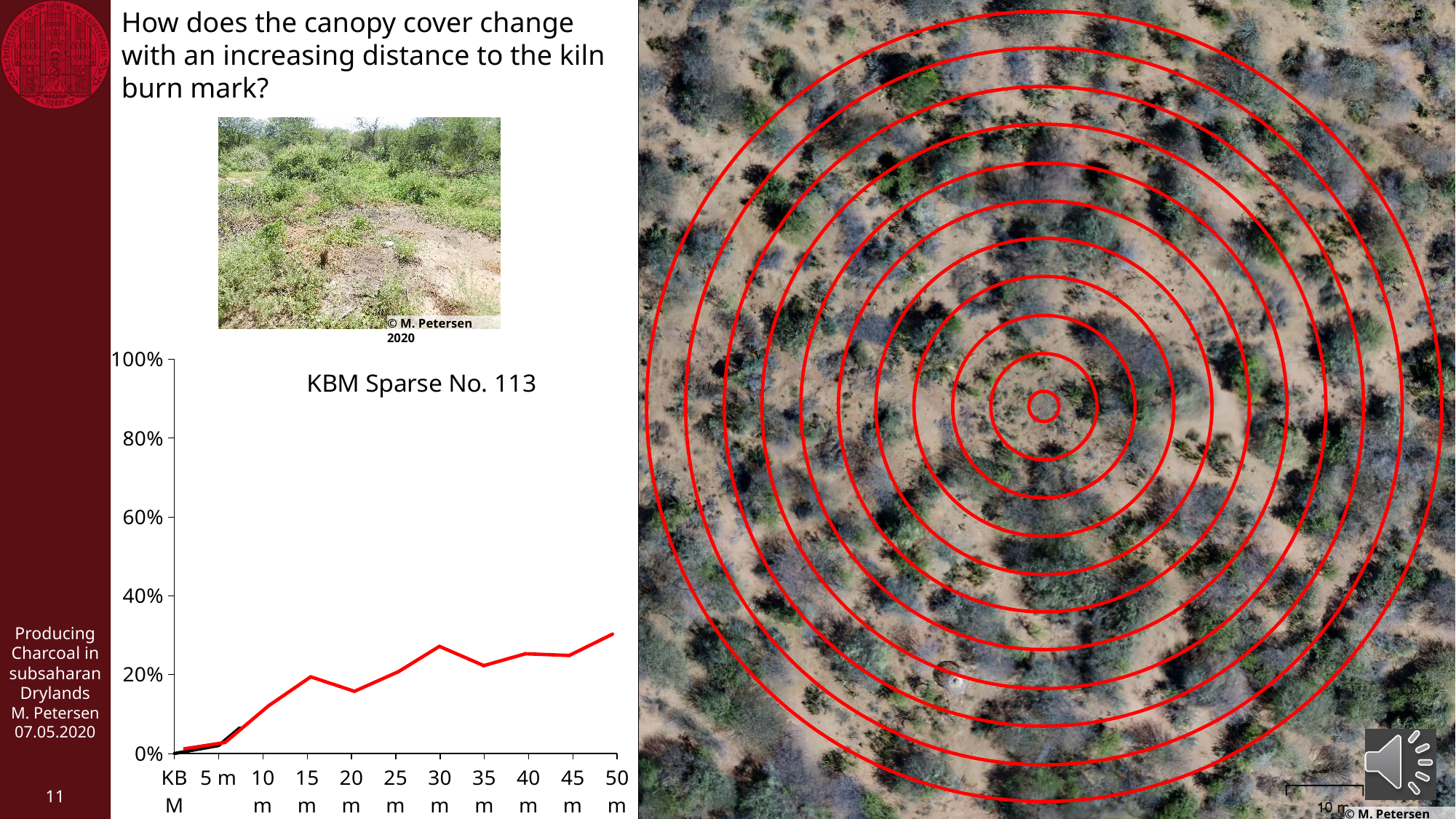
Is the canopy cover at 30 m greater or less than 40%? less Is the canopy cover at 5 m greater or less than 20%? less How many points are plotted along the x axis of the chart? 11 Which has the higher canopy cover, 30 m or 20 m? 30 m At which x-axis category is the canopy cover lowest? KBM What is the highest value shown on the y axis of the chart? 100% At which distance is the canopy cover highest? 50 m Overall, does the canopy cover rise or fall as the distance from the kiln burn mark increases? rise What is the title of the chart? KBM Sparse No. 113 Which has the higher canopy cover, 15 m or 20 m? 15 m Is the canopy cover at 50 m greater or less than 20%? greater What kind of chart is shown on the slide? line chart